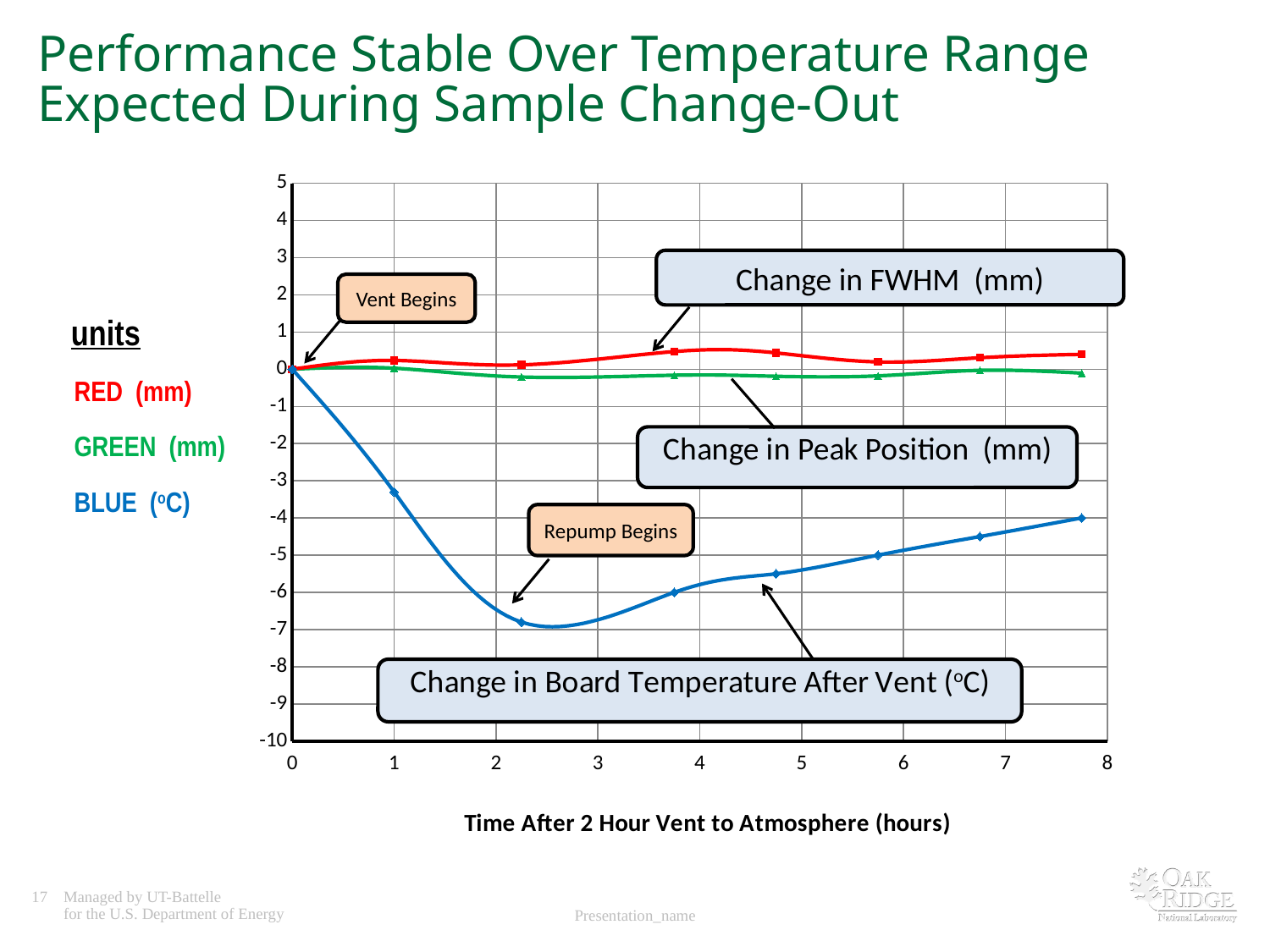
Is the value of the red Change in FWHM series at about 4 hours greater or less than 1? less Is the value of the blue Change in Board Temperature series at about 7.75 hours greater or less than -5? greater Which series reaches the lowest value on the chart? Change in Board Temperature After Vent (°C) At about 4 hours, which is larger: the red Change in FWHM value or the green Change in Peak Position value? Change in FWHM Does the blue Change in Board Temperature series rise or fall between 0 and about 2.25 hours? fall Is the value of the blue Change in Board Temperature series at 1 hour greater or less than -2? less In what units is the blue series (Change in Board Temperature After Vent) plotted? °C How many data series are plotted on the chart? 3 Does the blue Change in Board Temperature series rise or fall between about 2.25 hours and 7.75 hours? rise What kind of chart is shown on the slide? line chart What is the title of the x axis of the chart? Time After 2 Hour Vent to Atmosphere (hours)